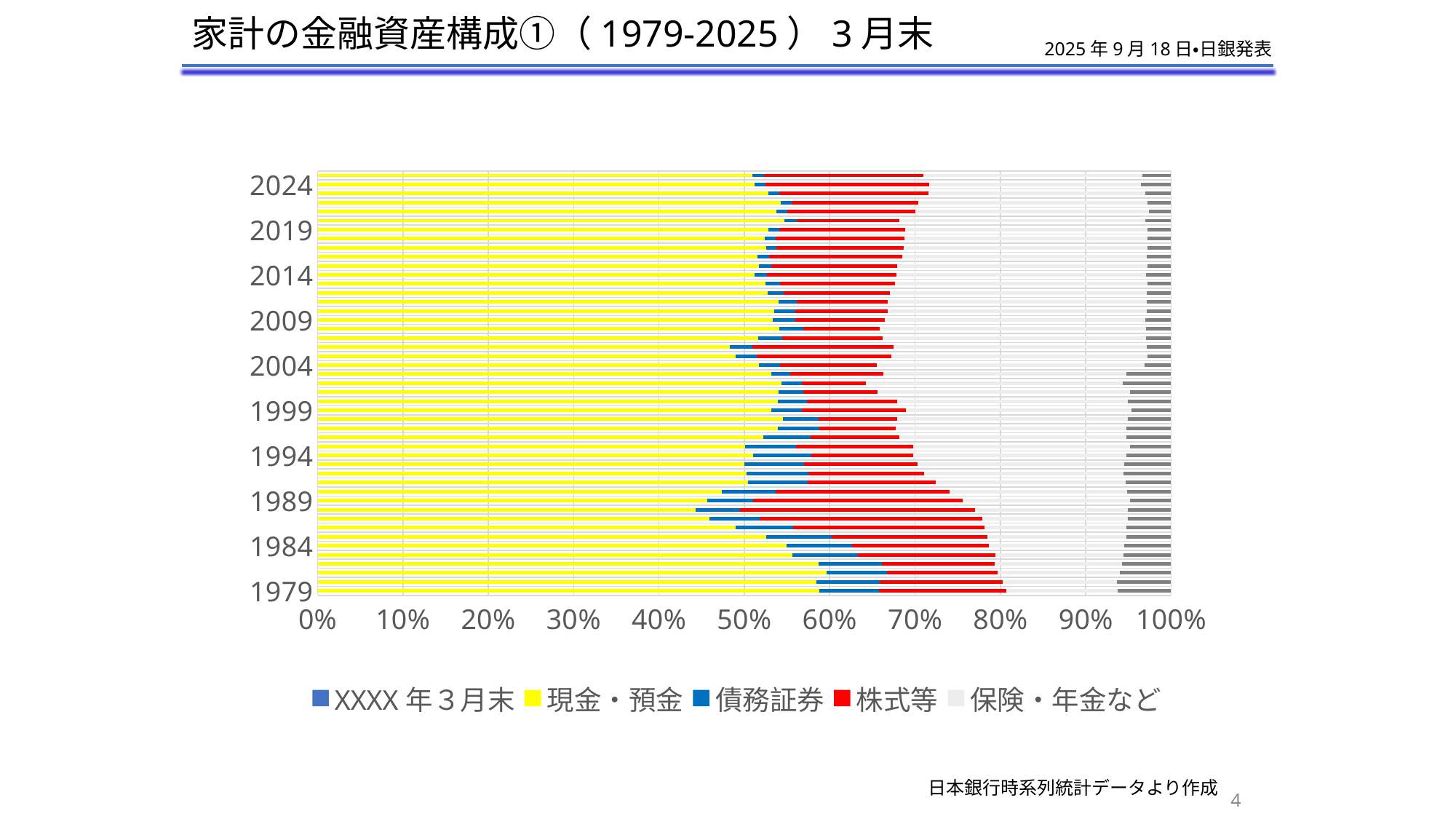
What kind of chart is shown on the slide? Stacked bar chart Which series is shown in yellow in the legend? 現金・預金 What is the highest value shown on the horizontal axis? 100% Is the 現金・預金 share for 1979 greater or less than 50%? greater Is the 現金・預金 share for 2009 greater or less than 40%? greater Which year has the larger 現金・預金 share, 1979 or 1989? 1979 Which year has the larger 債務証券 share, 1979 or 2024? 1979 How many series does the legend list? 5 Is the 現金・預金 share for 1989 greater or less than 50%? less What is the title of the chart on the slide? 家計の金融資産構成①（1979-2025）３月末 Which year has the larger 株式等 share, 1989 or 2009? 1989 Does the 現金・預金 share rise or fall from 1979 to 1989? fall